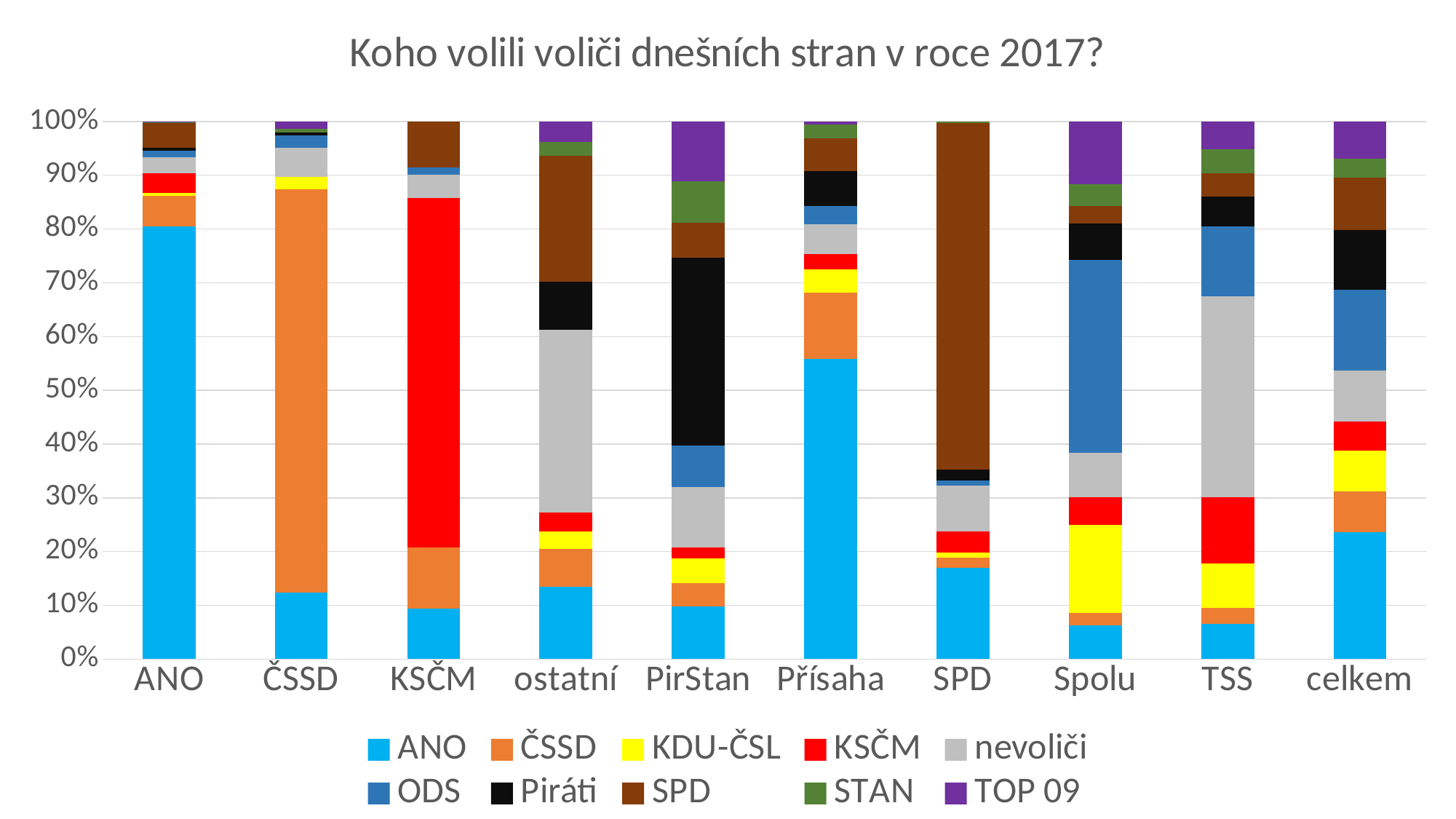
Which bar has the largest ANO segment, ANO or Přísaha? ANO What is the title of the chart? Koho volili voliči dnešních stran v roce 2017? Which bar has the largest Piráti segment? PirStan Is the ODS segment in the Spolu bar greater or less than 30%? greater How many bars (categories) are shown on the x axis? 10 What does each stacked bar total? 100% Is the ANO segment in the Přísaha bar greater or less than 50%? greater Is the ANO segment in the ANO bar greater or less than 70%? greater How many series does the legend list? 10 What kind of chart is shown on the slide? stacked bar chart Which bar has the largest ODS segment? Spolu